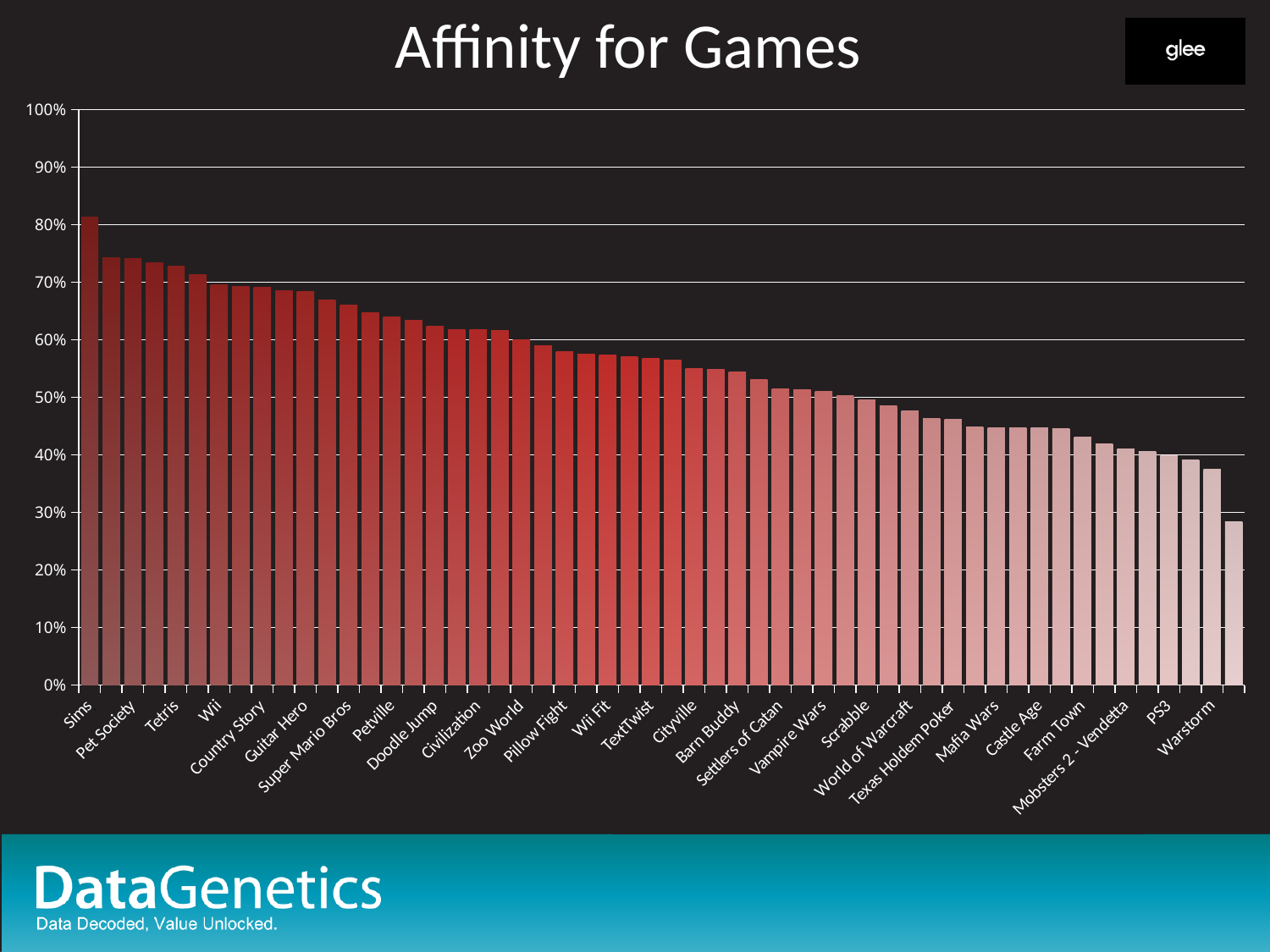
Is the value for Pillow Fight greater or less than 60%? less What kind of chart is shown on the slide? bar chart Is the value for World of Warcraft greater or less than 50%? less Is the value for Farm Town greater or less than 40%? greater Which has the larger value, Pet Society or Scrabble? Pet Society What is the title of the chart? Affinity for Games Do the values rise or fall moving from left to right along the x axis? fall Which game has the highest affinity value in the chart? Sims Which has the larger value, Sims or Tetris? Sims